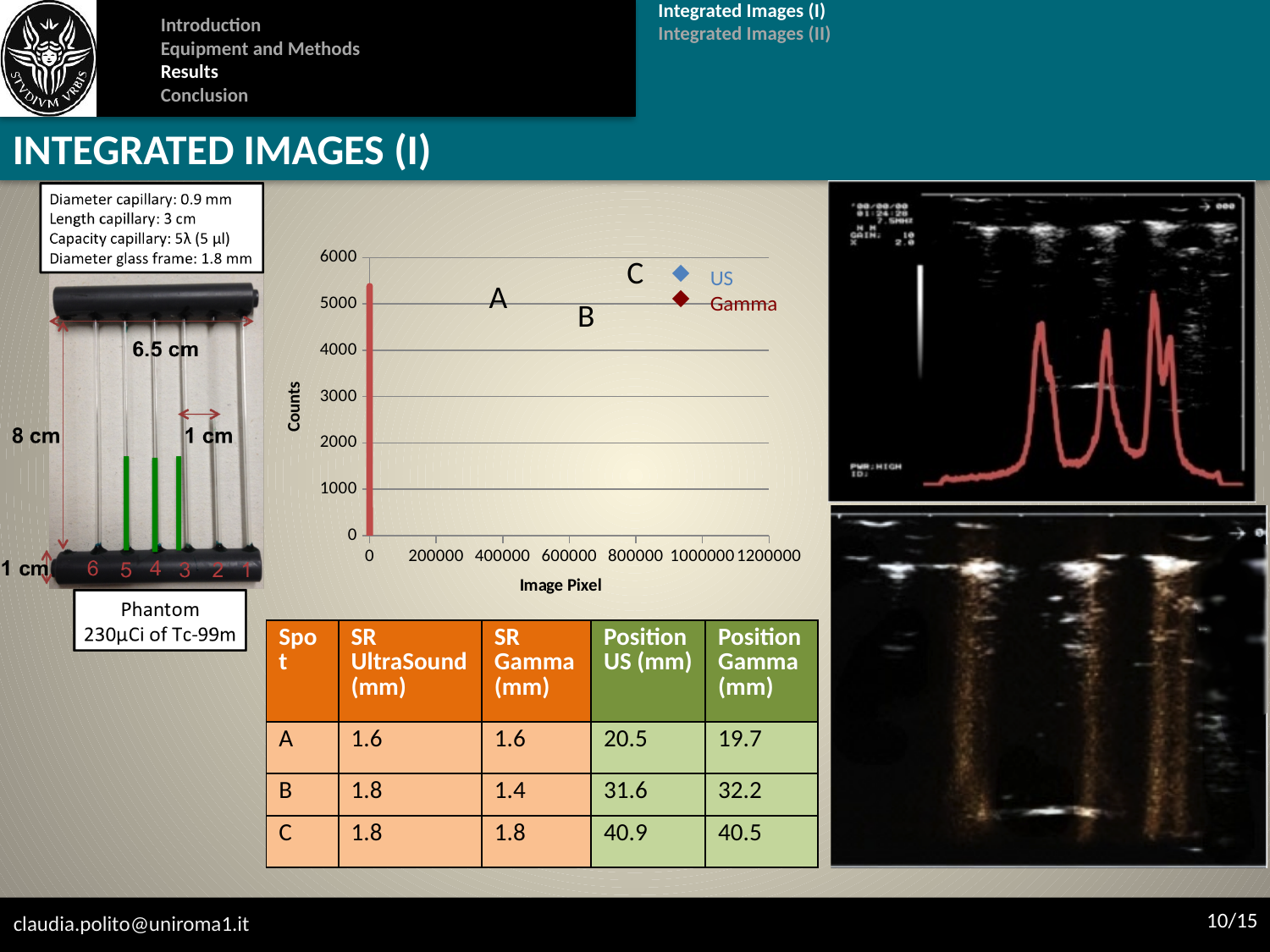
Is the peak of the red Gamma spike in the chart greater or less than 6000 counts? less Is the Image Pixel position of the red Gamma spike greater or less than 200000? less What kind of chart is the Counts vs Image Pixel plot? scatter chart What are the two series named in the chart legend? US and Gamma How many series does the legend of the Counts vs Image Pixel chart list? 2 Which series in the chart is drawn in red? Gamma How many lettered spots (A, B, C) are annotated on the chart? 3 Is the peak of the red Gamma spike in the chart greater or less than 5000 counts? greater